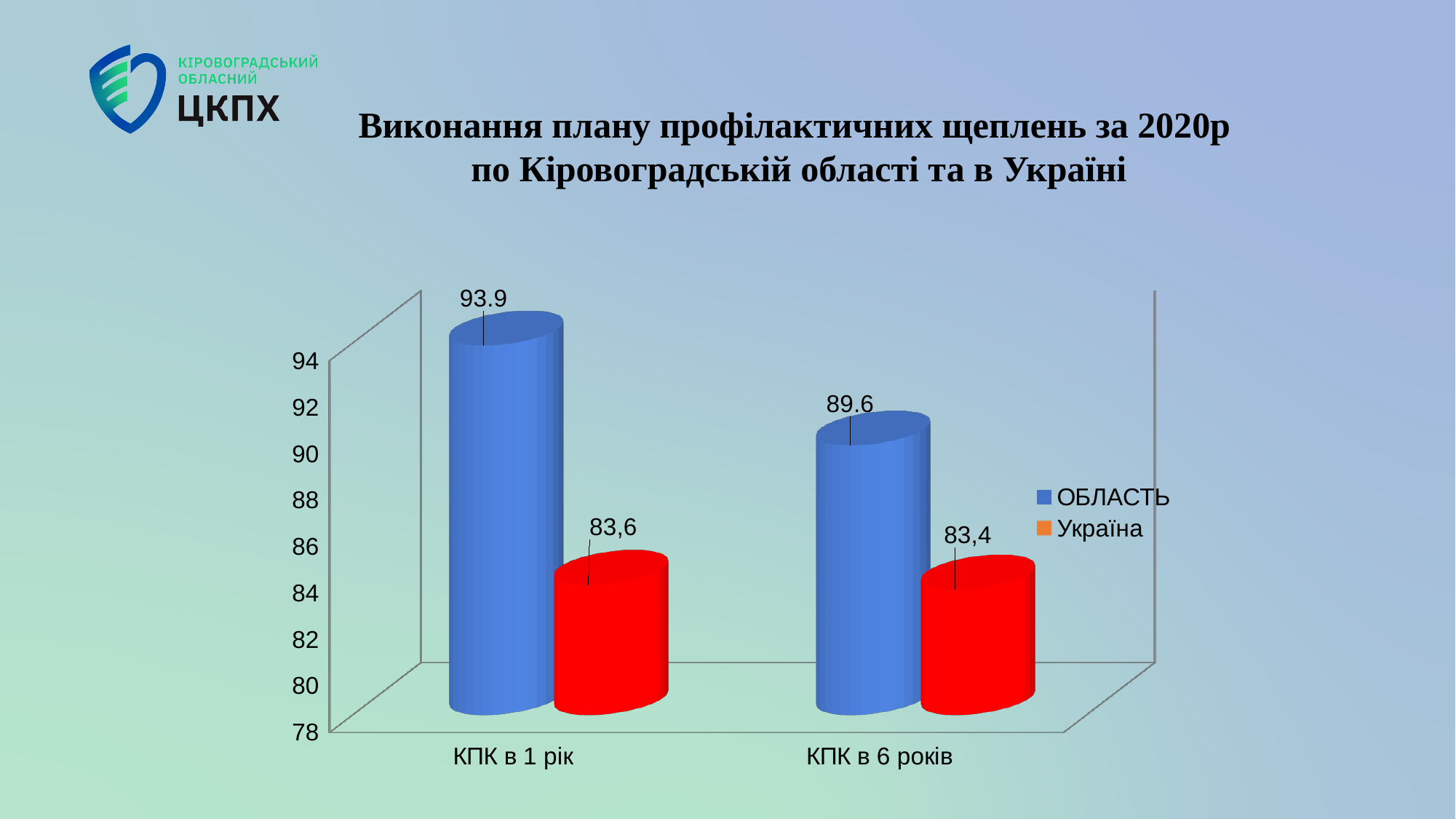
What is the value for Україна in the КПК в 1 рік category? 83,6 Which category has the highest ОБЛАСТЬ value? КПК в 1 рік Which bar has the lowest value on the chart? Україна, КПК в 6 років Is the value for ОБЛАСТЬ in КПК в 1 рік greater or less than 90? greater What kind of chart is shown on the slide? bar chart What is the value for Україна in the КПК в 6 років category? 83,4 How many categories are shown on the x axis? 2 What is the difference between the ОБЛАСТЬ values for КПК в 1 рік and КПК в 6 років? 4.3 What is the value for ОБЛАСТЬ in the КПК в 6 років category? 89.6 In the КПК в 6 років category, which is larger: ОБЛАСТЬ or Україна? ОБЛАСТЬ What is the value for ОБЛАСТЬ in the КПК в 1 рік category? 93.9 How many series does the legend list? 2